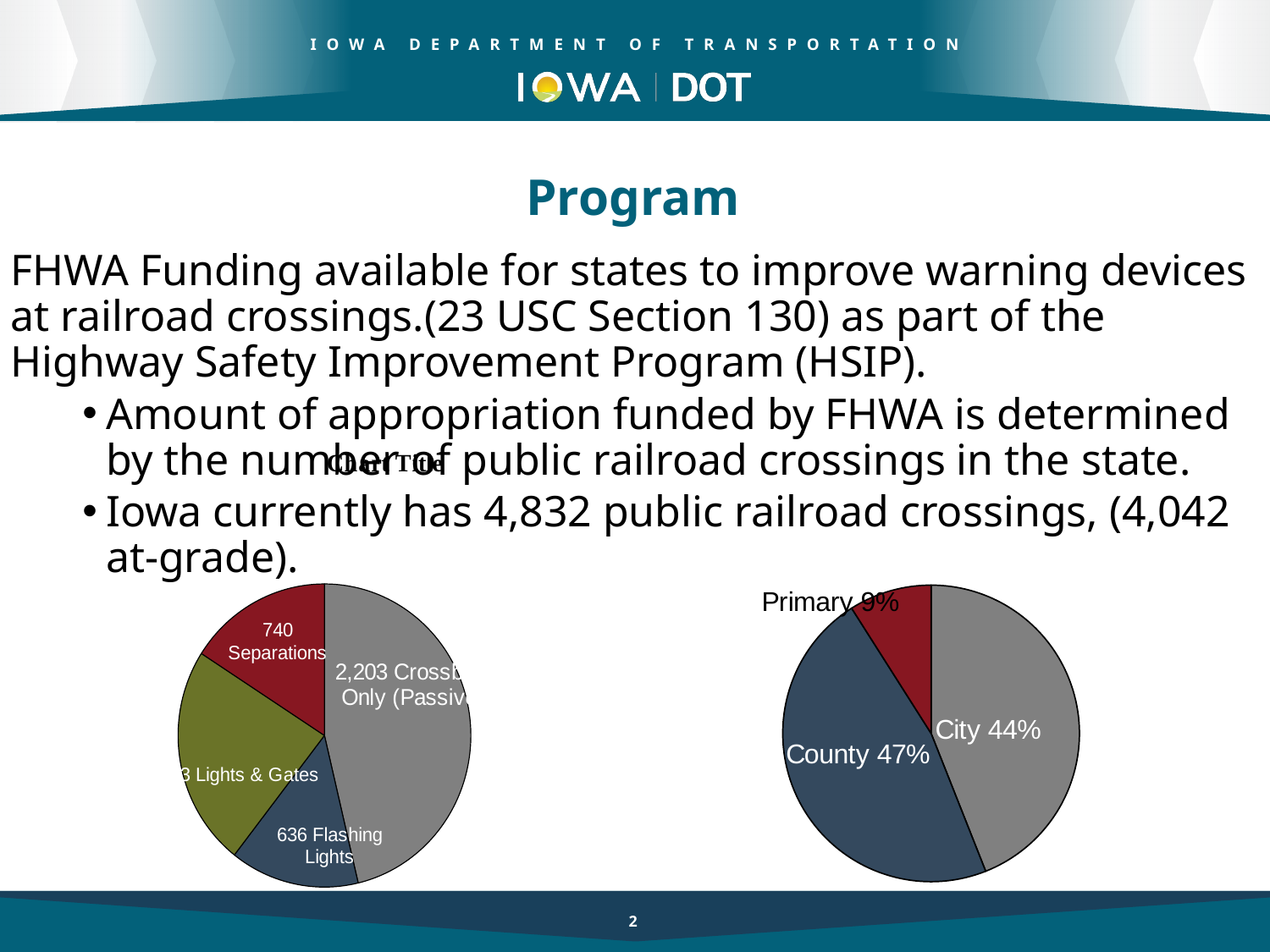
In the pie chart on the right, which category has the smallest share? Primary In the pie chart on the left, which is larger, Separations or Flashing Lights? Separations In the pie chart on the right, how many percentage points larger is County's share than City's share? 3 In the pie chart on the right, what share is labelled for City? 44% How many slices does the pie chart on the right have? 3 What kind of chart is the chart on the right of the slide? pie chart In the pie chart on the right, what share is labelled for County? 47% In the pie chart on the right, what share is labelled for Primary? 9% In the pie chart on the left, what value is labelled for Separations? 740 In the pie chart on the left, what value is labelled for Flashing Lights? 636 In the pie chart on the right, which category has the largest share? County What kind of chart is the chart on the left of the slide? pie chart